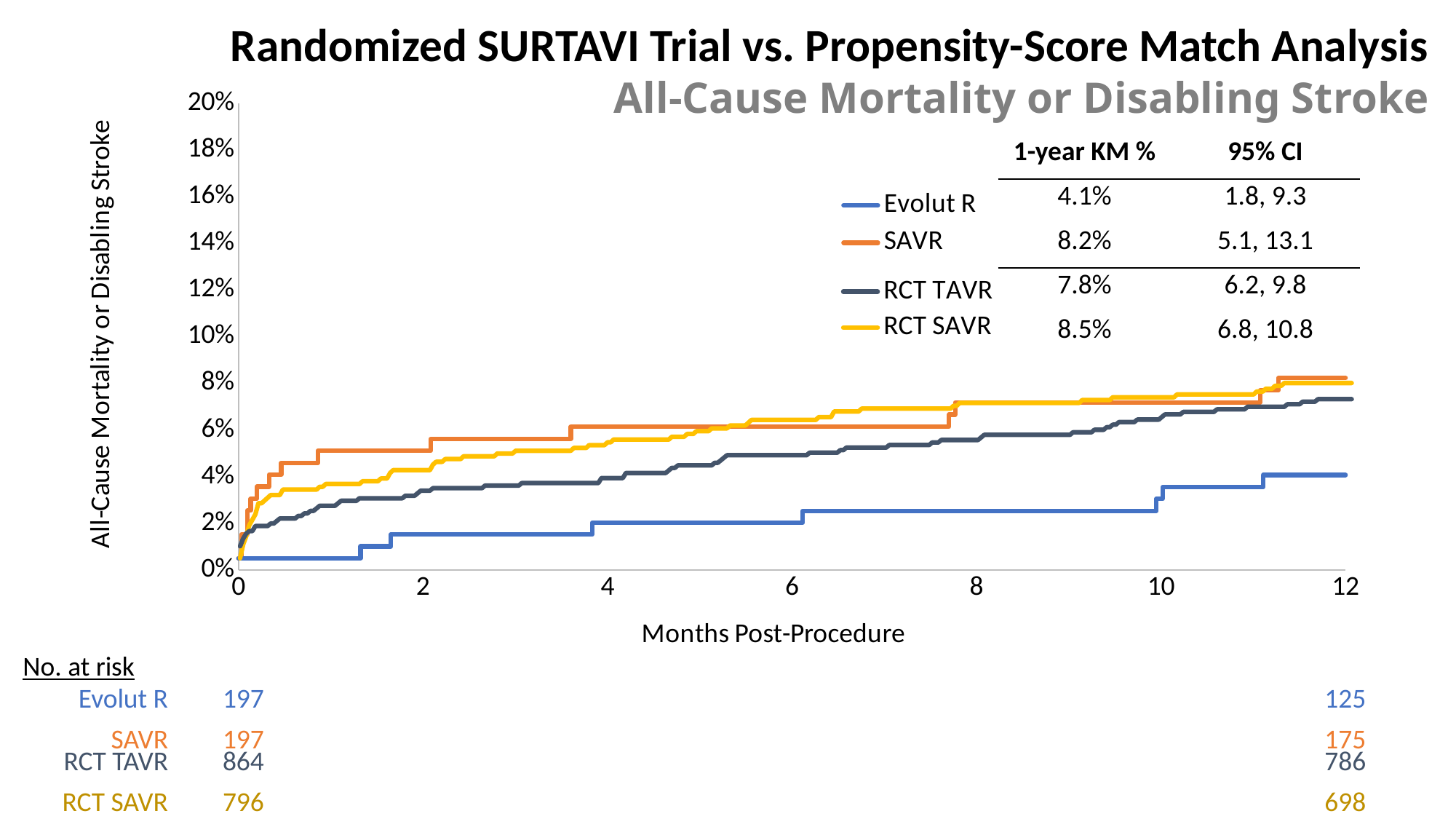
What is the 95% CI for SAVR? 5.1, 13.1 Which series has the highest 1-year KM %? RCT SAVR What is the difference between the 1-year KM % for SAVR and for Evolut R? 4.1 percentage points Do the curves rise or fall as months post-procedure increase? rise What kind of chart is shown on the slide? line chart How many Evolut R patients were at risk at 12 months? 125 What is the 1-year KM % for Evolut R? 4.1% What is the 1-year KM % for RCT SAVR? 8.5% Is the value for Evolut R at 6 months post-procedure greater or less than 4%? less Which series has the lowest 1-year KM %? Evolut R Which has a larger 1-year KM %, RCT TAVR or RCT SAVR? RCT SAVR How many series does the legend list? 4